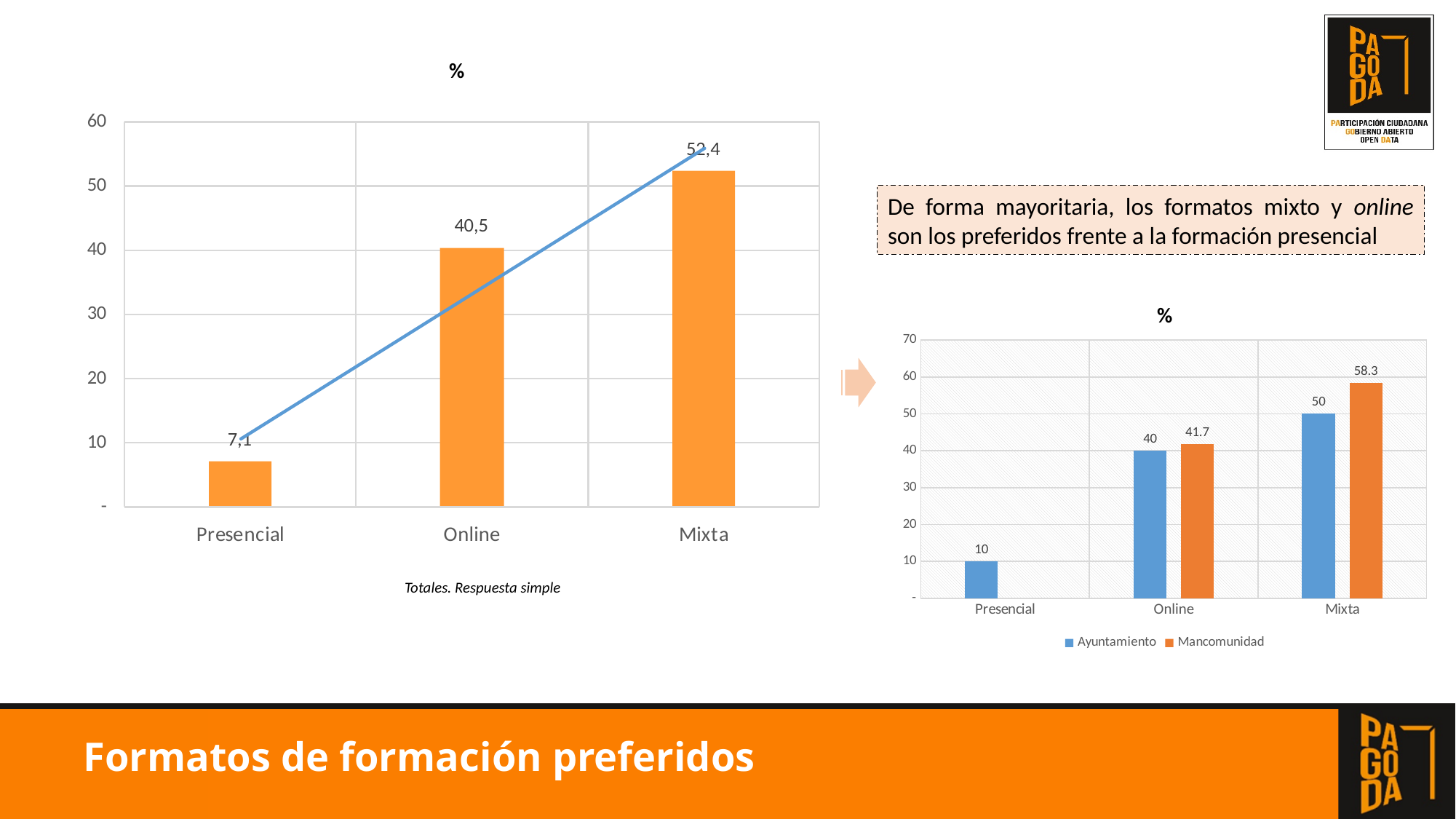
In the left chart (Totales. Respuesta simple), what is the value for Online? 40,5 In the right chart, how many series does the legend list? 2 In the right chart, what is the Mancomunidad value for Mixta? 58.3 In the left chart (Totales. Respuesta simple), which category has the highest value? Mixta In the right chart, what is the difference between the Mancomunidad and Ayuntamiento values for Mixta? 8.3 In the right chart, what is the Ayuntamiento value for Online? 40 In the left chart (Totales. Respuesta simple), what is the value for Presencial? 7,1 What kind of chart is the right chart? bar chart In the left chart (Totales. Respuesta simple), do the values rise or fall from Presencial to Mixta? rise In the right chart, which is larger for Mixta: Ayuntamiento or Mancomunidad? Mancomunidad In the left chart (Totales. Respuesta simple), which category has the lowest value? Presencial In the left chart (Totales. Respuesta simple), what is the difference between the values for Mixta and Online? 11,9